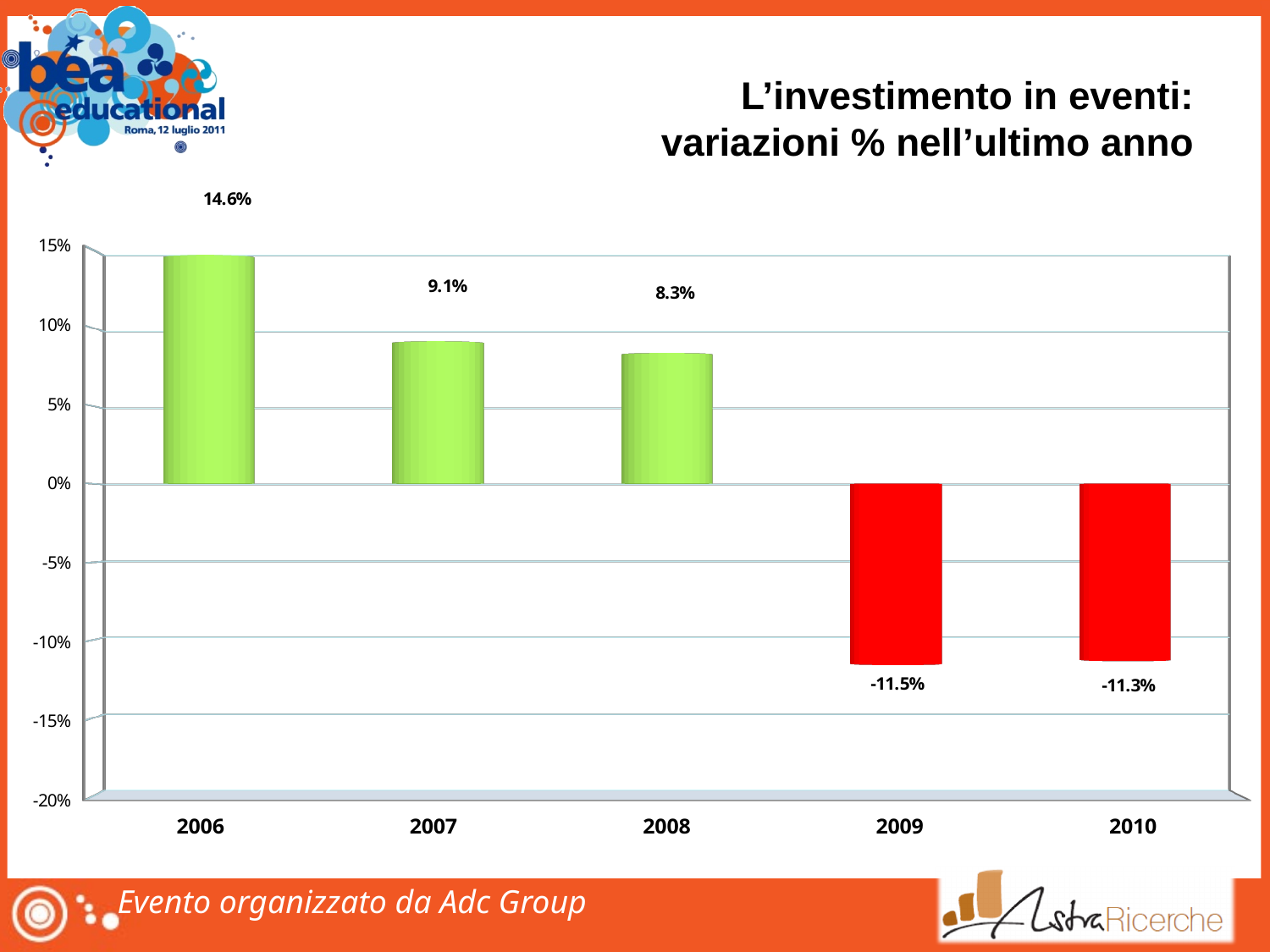
What kind of chart is shown on the slide? bar chart Which year has the highest value? 2006 Which is larger, the value for 2007 or the value for 2008? 2007 What is the value for 2006? 14.6% Is the value for 2008 greater or less than 10%? less What colour are the bars with negative values? red What is the difference between the values for 2007 and 2008? 0.8% Which year has the lowest value? 2009 What is the value for 2009? -11.5% What is the difference between the values for 2006 and 2007? 5.5% What is the value for 2010? -11.3% How many years are shown on the x axis? 5